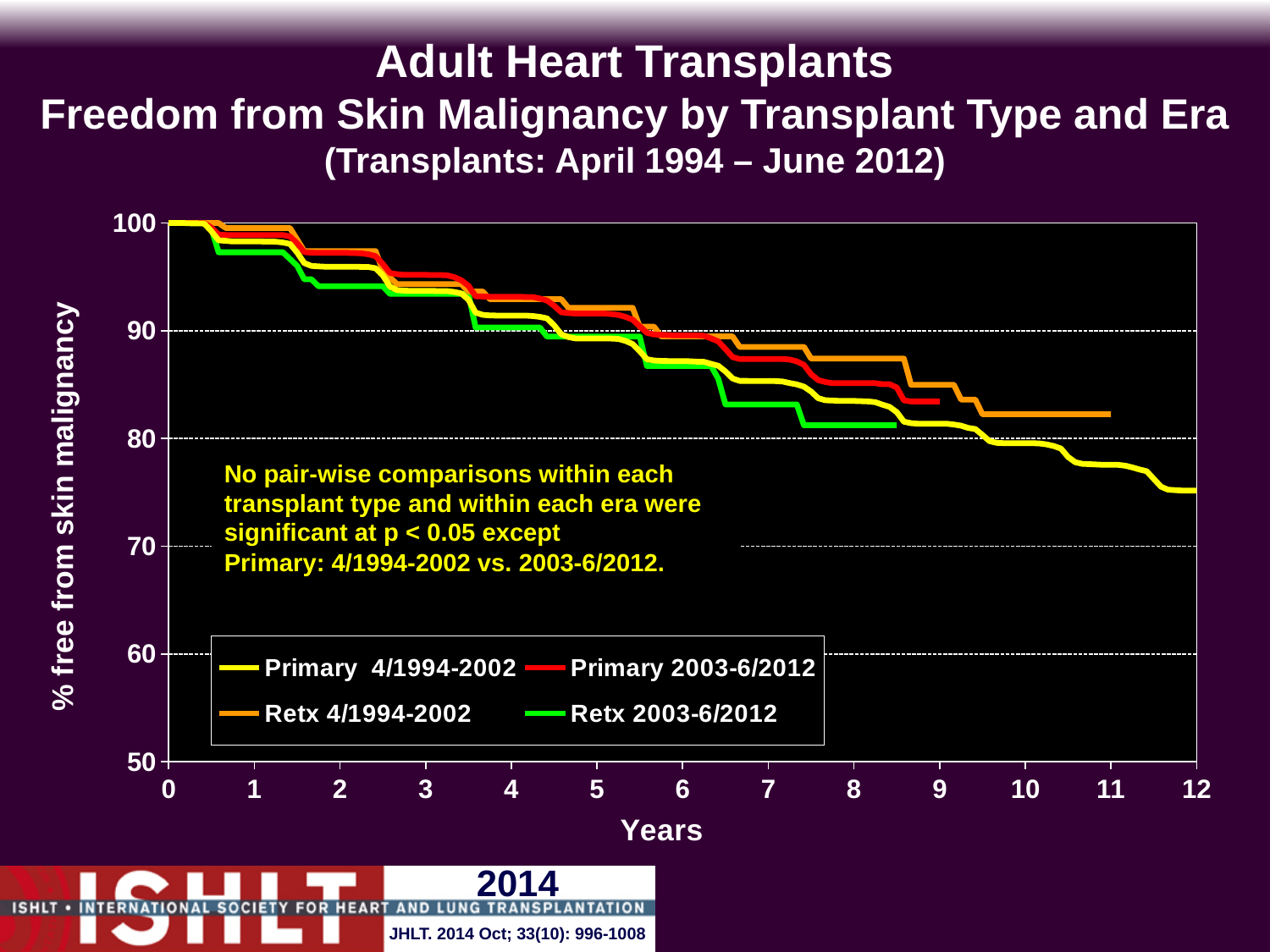
Is the value for Primary 4/1994-2002 at 12 years greater or less than 80? less At 8 years, which is higher: Retx 4/1994-2002 or Primary 4/1994-2002? Retx 4/1994-2002 Is the value for Primary 4/1994-2002 at 6 years greater or less than 90? less Is the value for Retx 4/1994-2002 at 11 years greater or less than 80? greater How many series does the legend list? 4 At 7 years, which is higher: Retx 4/1994-2002 or Retx 2003-6/2012? Retx 4/1994-2002 What colour is the line for Retx 2003-6/2012? green Do the values for Primary 4/1994-2002 rise or fall as years increase? fall Which series extends furthest along the x axis, reaching 12 years? Primary 4/1994-2002 What kind of chart is shown on the slide? line chart What is the label of the y axis? % free from skin malignancy